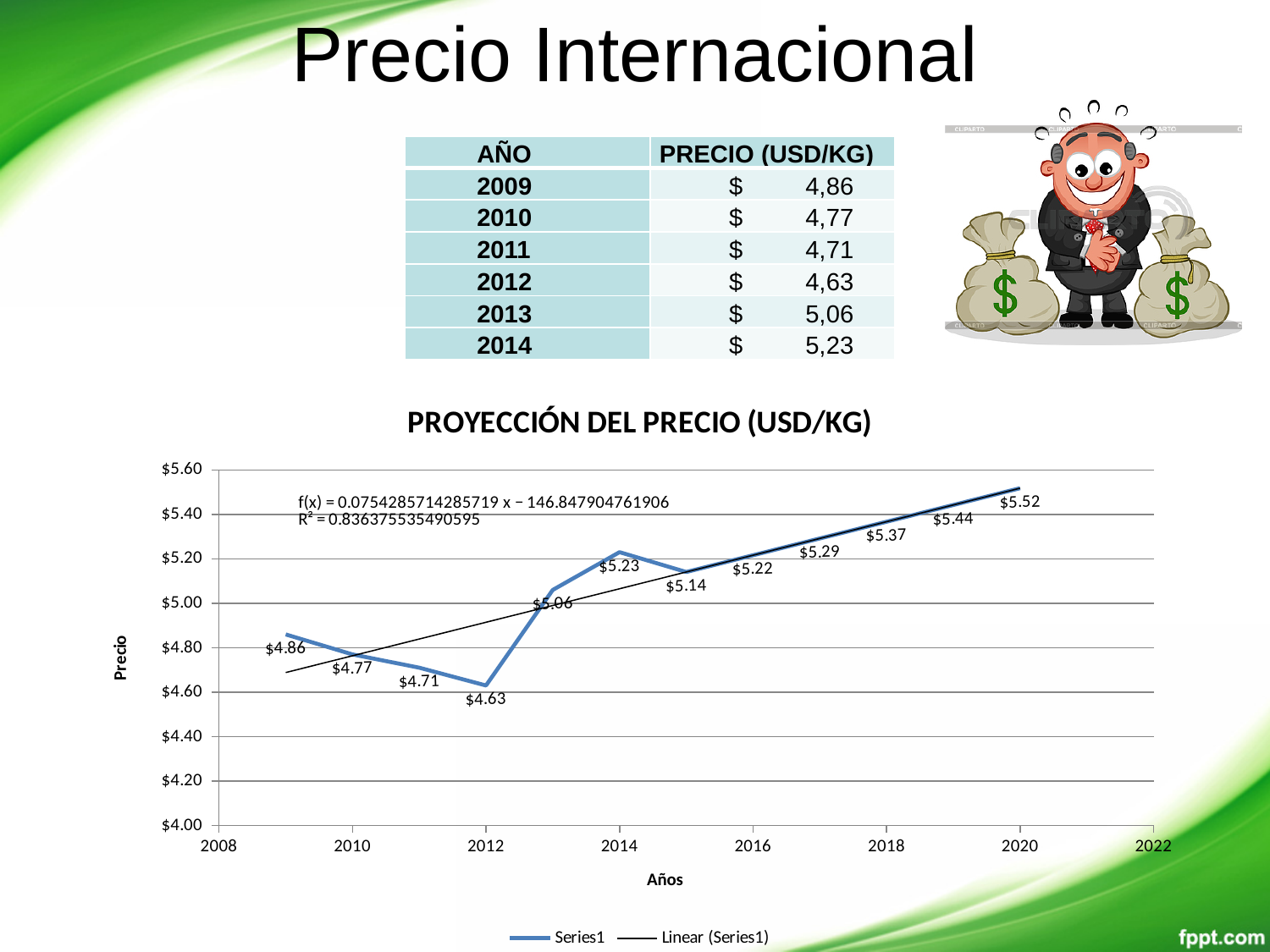
Which is larger, the value for 2015 or the value for 2014? 2014 How many entries does the legend list? 2 What is the label of the vertical axis? Precio What is the value plotted for 2020? $5.52 What is the chart's title? PROYECCIÓN DEL PRECIO (USD/KG) What type of chart is shown on the slide? line chart Which year has the lowest plotted value? 2012 Which year has the highest plotted value? 2020 What is the value plotted for 2012? $4.63 What is the value plotted for 2014? $5.23 What is the difference between the values for 2014 and 2013? $0.17 How many data points are plotted on the line? 12